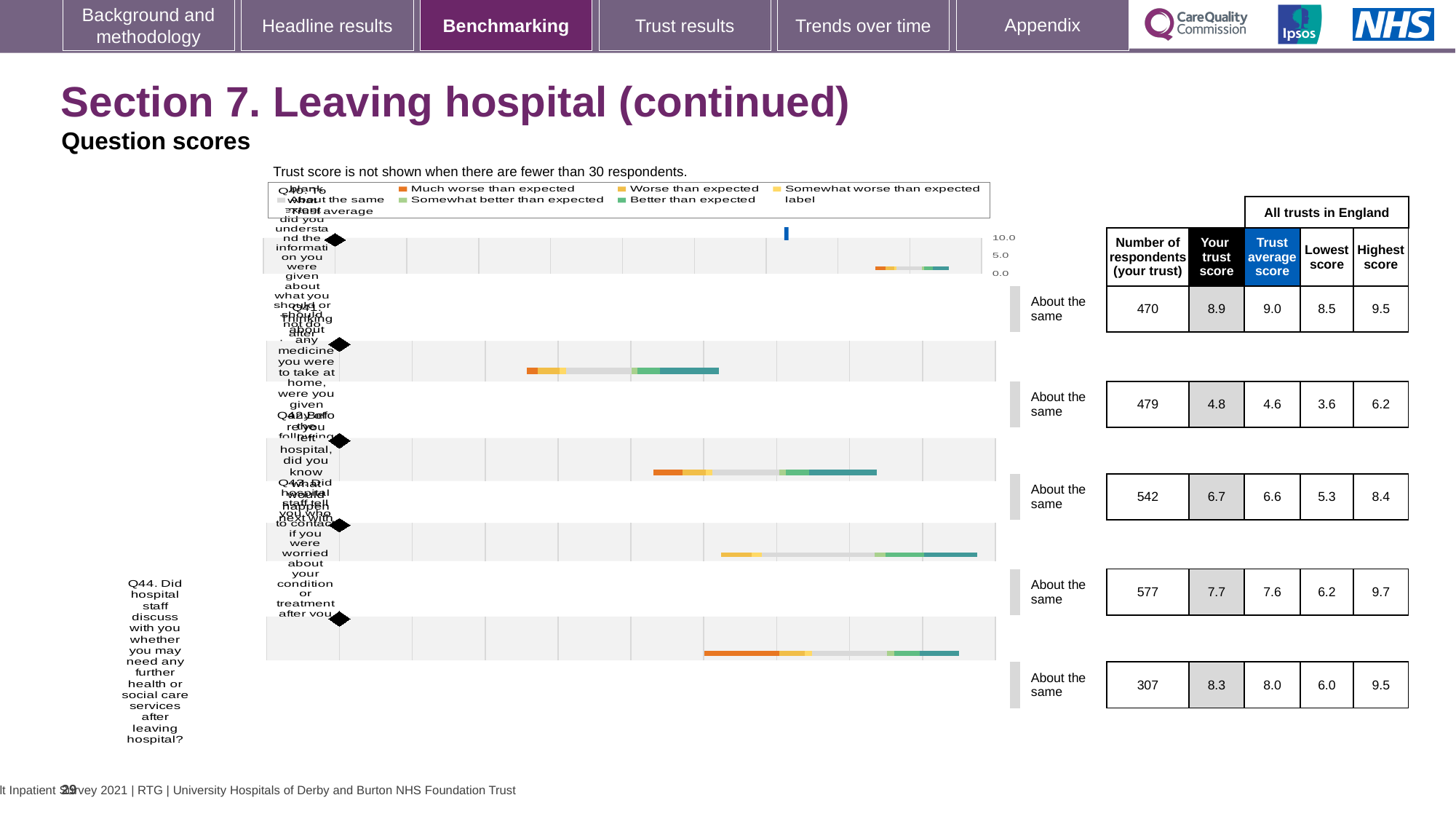
Which row has more respondents: the first row (470) or the fourth row (577)? The fourth row (577) What type of chart is used to show the question scores? Bar chart Which question row has the lowest 'Your trust score' in the table? The second row (4.8) Which question row has the highest 'Your trust score' in the table? The first row (8.9) What benchmark category is shown for every question on this slide? About the same What is the number of respondents for Q44 (further health or social care services after leaving hospital)? 307 What is the trust average score for Q44 (further health or social care services after leaving hospital)? 8.0 What is the lowest score across all trusts in England for Q44? 6.0 How many question rows are shown in the benchmarking chart? 5 What is the highest score across all trusts in England for Q44? 9.5 What is the trust score for Q44 (further health or social care services after leaving hospital)? 8.3 What is the difference between the highest score and the lowest score for Q44? 3.5